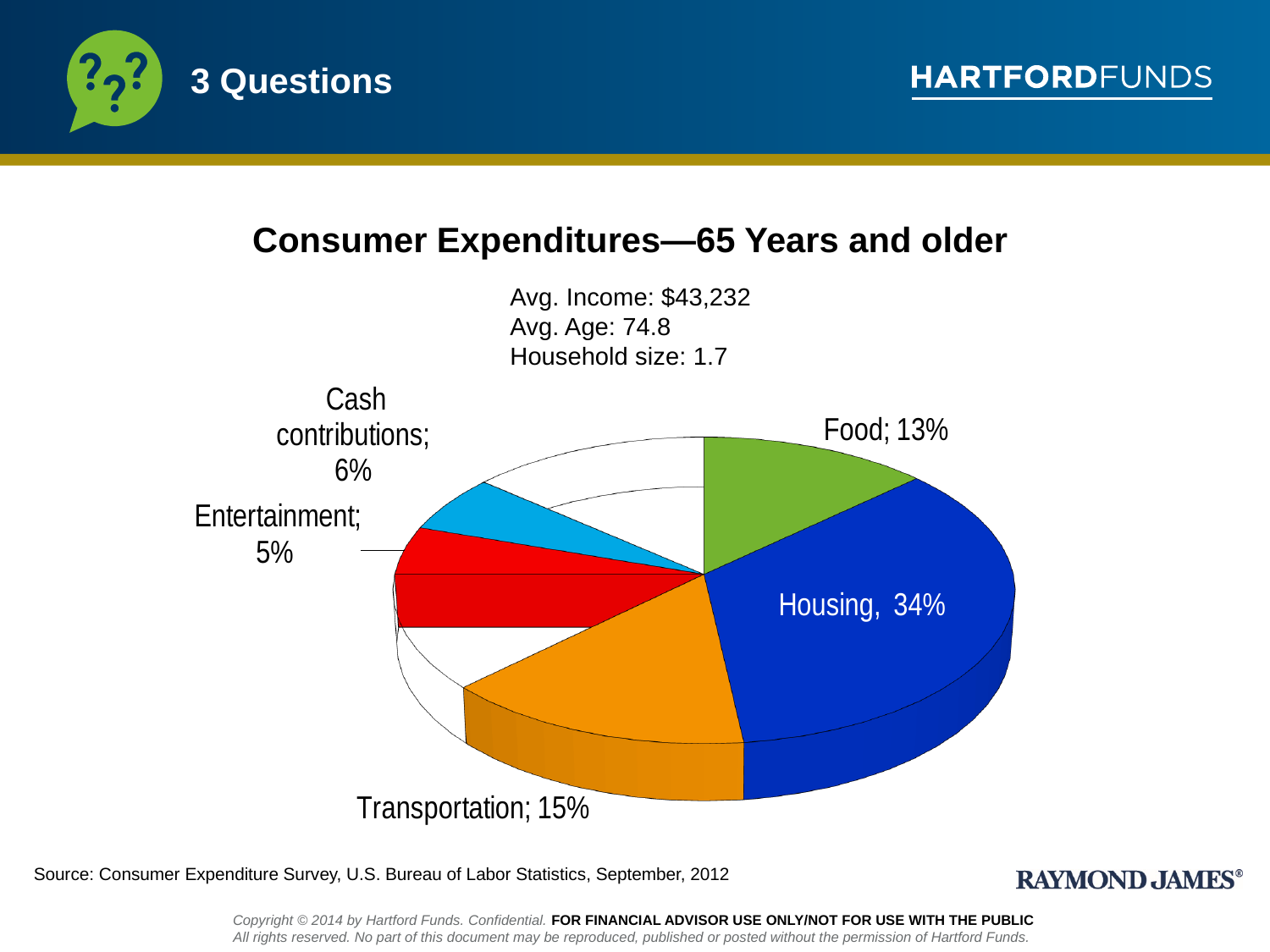
Which labeled category has the largest share of the pie? Housing Which is larger, the share for Cash contributions or the share for Entertainment? Cash contributions What is the difference in percentage points between Transportation and Food? 2 What percentage of consumer expenditures goes to Housing? 34% How many percentage points larger is Housing than Food? 21 What kind of chart is shown on the slide? Pie chart What percentage is shown for Transportation? 15% What share of expenditures is labeled for Food? 13% What percentage is shown for Cash contributions? 6% What is the title of the chart? Consumer Expenditures—65 Years and older What percentage is shown for Entertainment? 5% Which labeled category has the smallest share of the pie? Entertainment